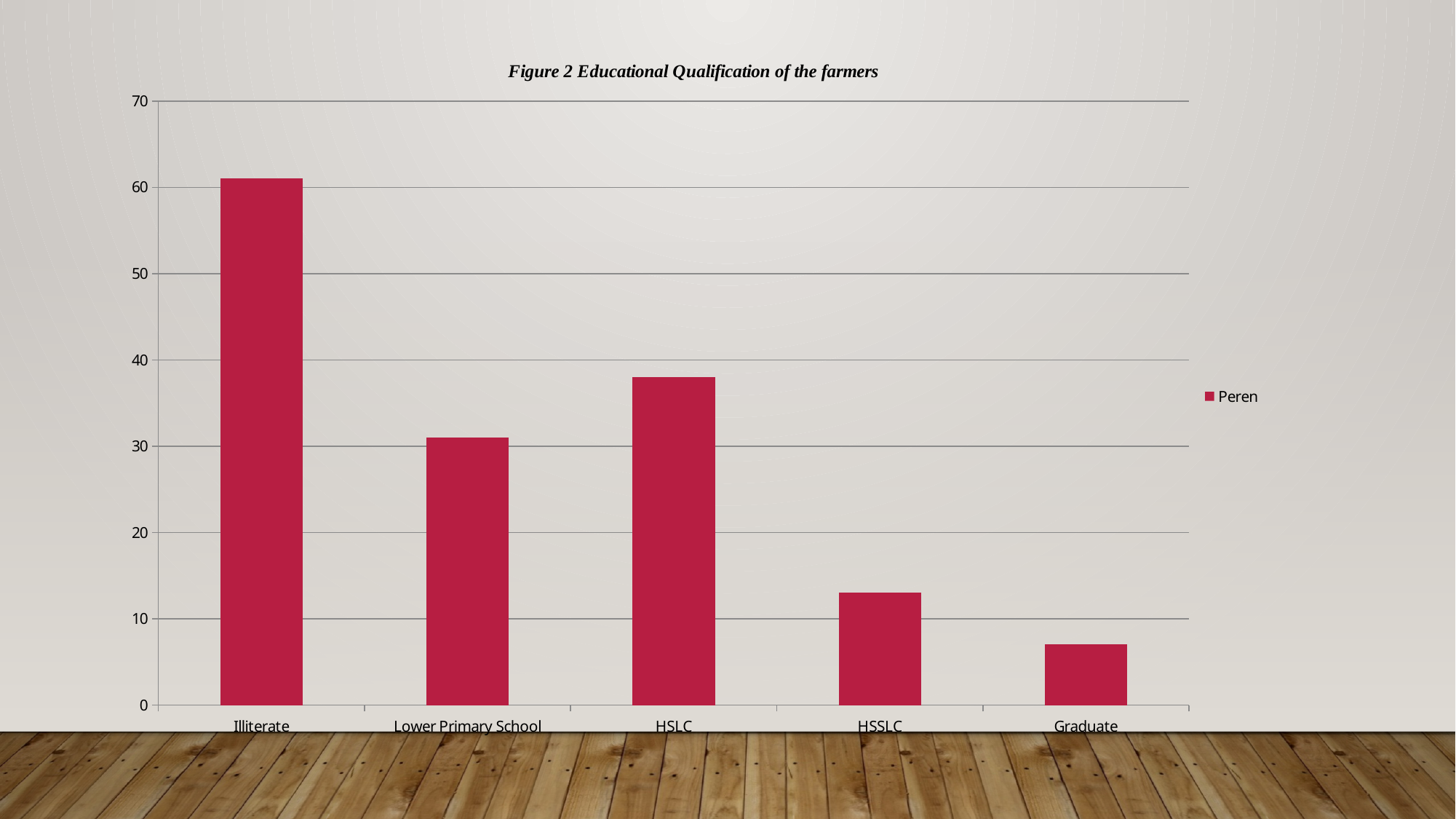
Is the value for Graduate greater or less than 10? less How many educational qualification categories are shown on the x axis? 5 Is the value for Illiterate greater or less than 50? greater What is the title of the chart? Figure 2 Educational Qualification of the farmers Which category has the highest value? Illiterate Is the value for HSLC greater or less than 40? less Which category has the lowest value? Graduate What kind of chart is shown on the slide? bar chart Which is larger, the value for HSLC or the value for Lower Primary School? HSLC What is the name of the series shown in the legend? Peren How many series does the legend list? 1